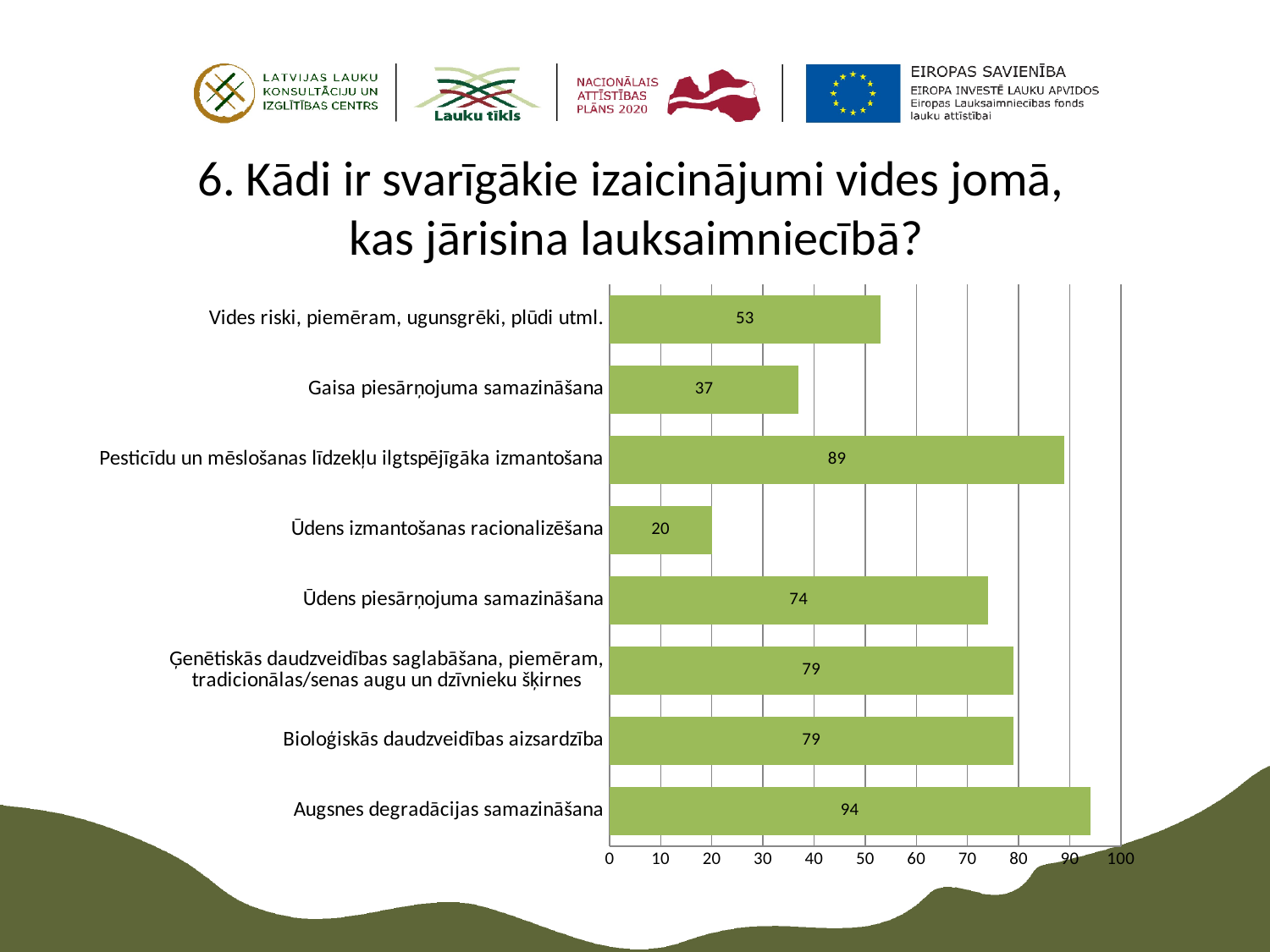
What is the difference between the values for "Augsnes degradācijas samazināšana" and "Ūdens izmantošanas racionalizēšana"? 74 Which category has the highest value? Augsnes degradācijas samazināšana Which is larger: the value for "Vides riski, piemēram, ugunsgrēki, plūdi utml." or the value for "Ūdens piesārņojuma samazināšana"? Ūdens piesārņojuma samazināšana What kind of chart is shown on the slide? bar chart What is the difference between the values for "Pesticīdu un mēslošanas līdzekļu ilgtspējīgāka izmantošana" and "Gaisa piesārņojuma samazināšana"? 52 Is the value for "Bioloģiskās daudzveidības aizsardzība" greater or less than 70? greater Which category has the lowest value? Ūdens izmantošanas racionalizēšana What is the value for "Augsnes degradācijas samazināšana"? 94 How many categories are shown in the chart? 8 What is the value for "Ūdens izmantošanas racionalizēšana"? 20 What is the value for "Gaisa piesārņojuma samazināšana"? 37 What is the value for "Pesticīdu un mēslošanas līdzekļu ilgtspējīgāka izmantošana"? 89